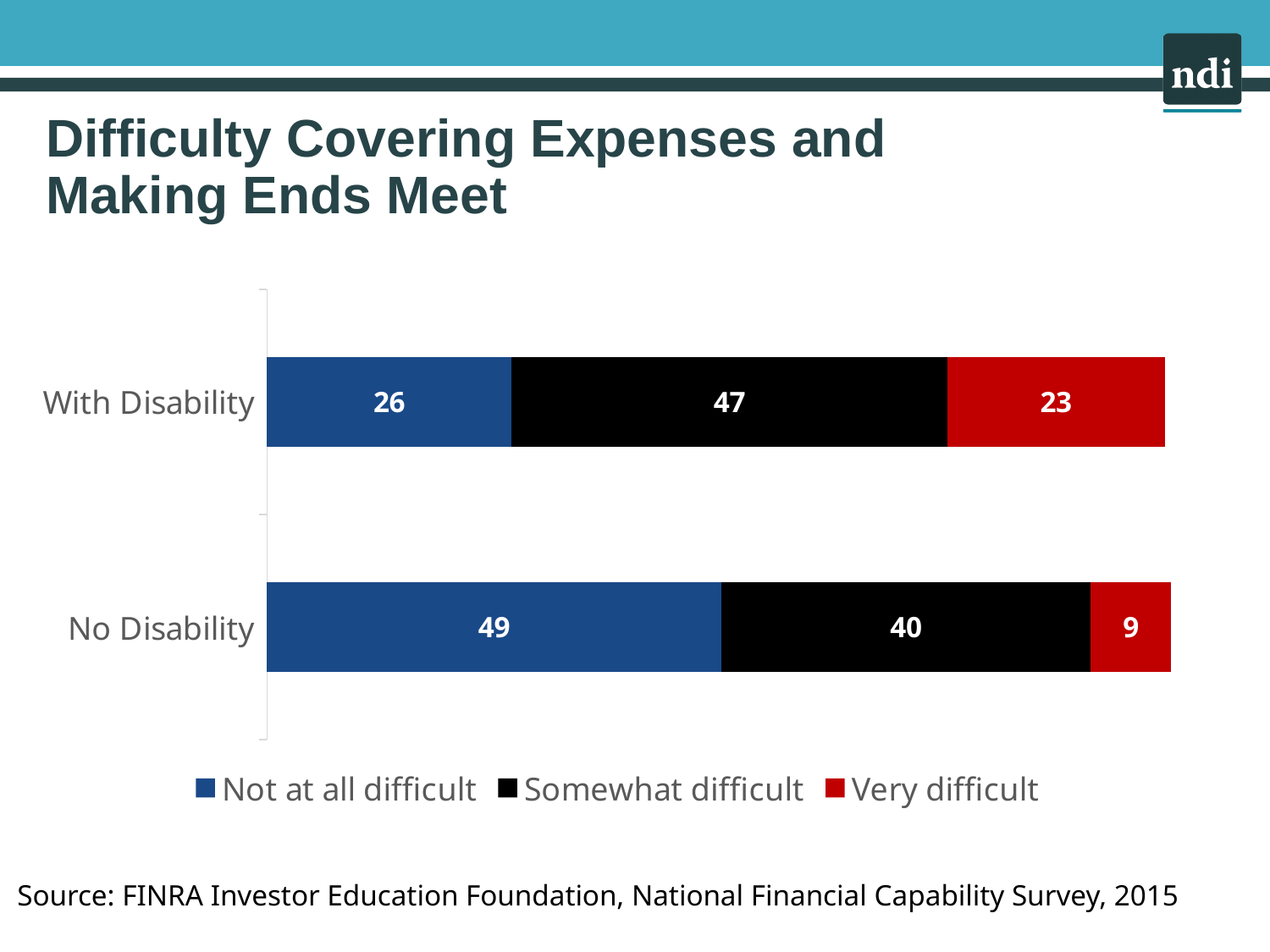
How many series does the legend list? 3 What is the value for "Not at all difficult" in the No Disability bar? 49 Which category has the higher "Not at all difficult" value, With Disability or No Disability? No Disability What kind of chart is shown on the slide? Stacked bar chart What is the difference between the "Not at all difficult" values for No Disability and With Disability? 23 What is the value for "Somewhat difficult" in the With Disability bar? 47 How many categories are shown on the chart? 2 What is the difference between the "Very difficult" values for With Disability and No Disability? 14 What is the value for "Very difficult" in the No Disability bar? 9 What is the total of the No Disability stacked bar? 98 What is the total of the With Disability stacked bar? 96 What is the value for "Very difficult" in the With Disability bar? 23